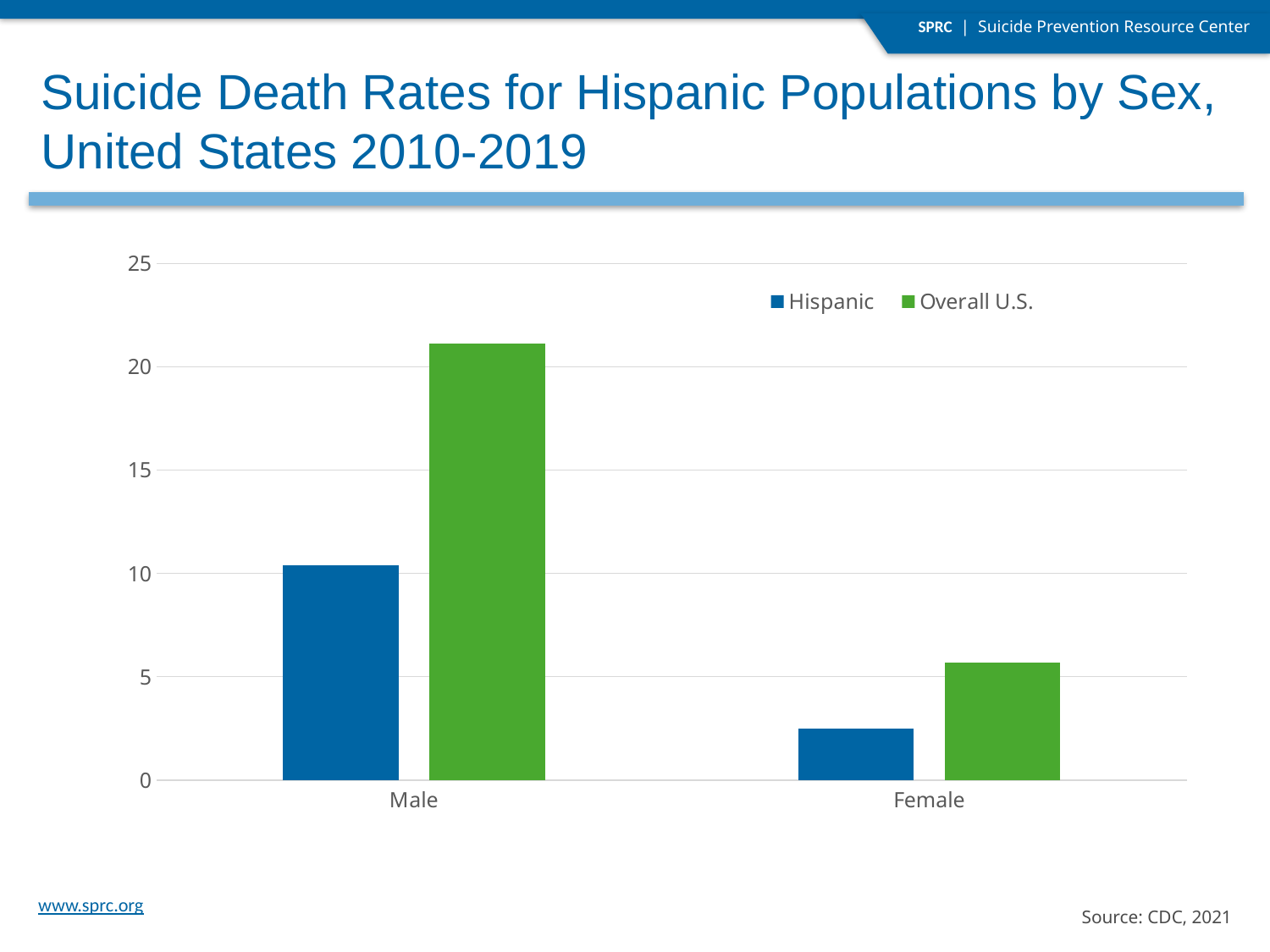
Which bar is the lowest in the chart? Hispanic for Female How many categories are shown on the x axis? 2 For the Hispanic series, which category has the larger value, Male or Female? Male Is the Hispanic value for Male greater or less than 15? less For Male, which is larger: the Hispanic value or the Overall U.S. value? Overall U.S. Which bar is the highest in the chart? Overall U.S. for Male What kind of chart is shown on the slide? Bar chart Is the Overall U.S. value for Female greater or less than 10? less Is the Hispanic value for Female greater or less than 5? less How many series does the legend list? 2 What colour represents the Overall U.S. series in the chart? Green